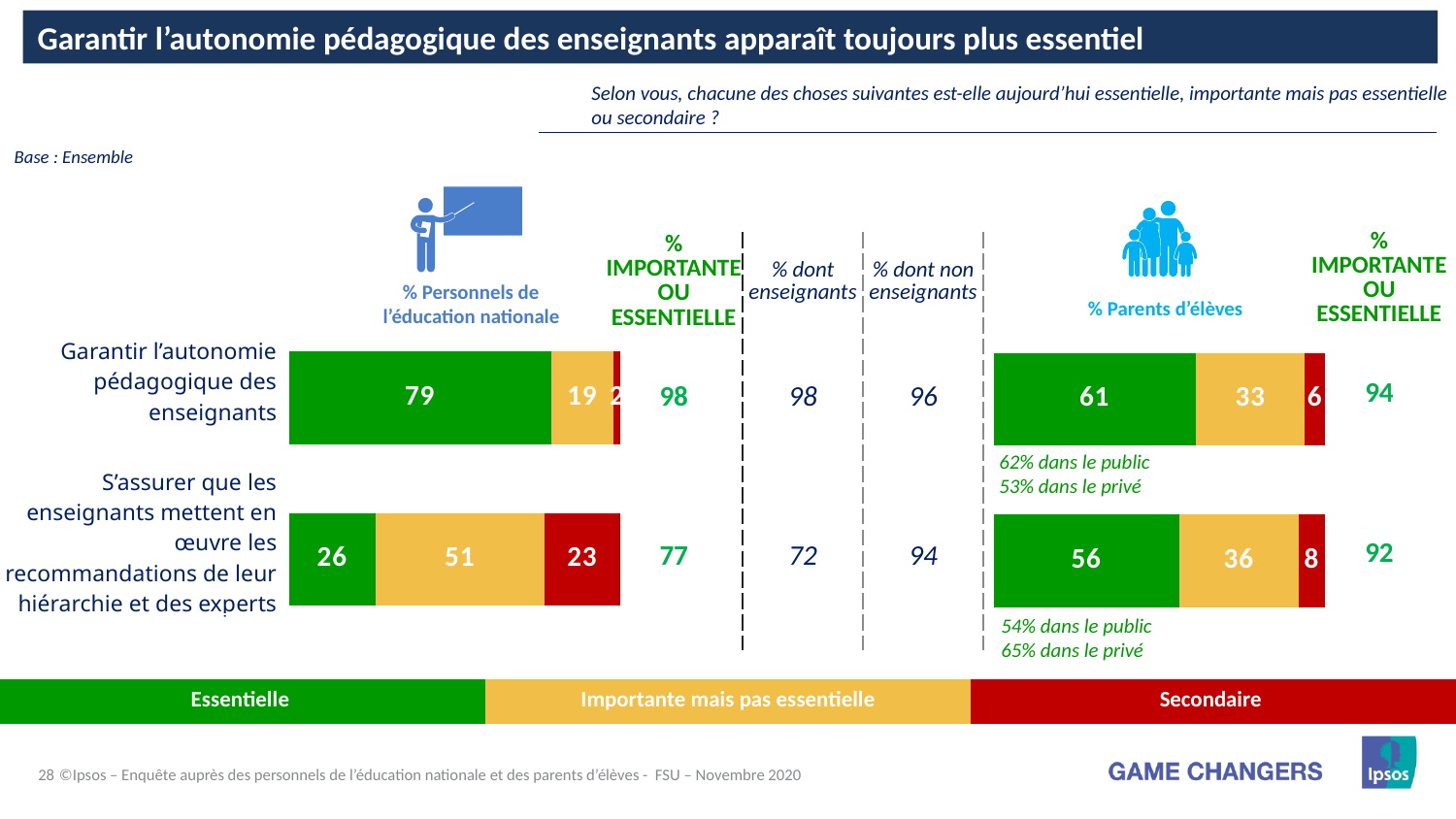
Is the Essentielle value for 'Garantir l'autonomie pédagogique des enseignants' larger in the '% Personnels de l'éducation nationale' chart or in the '% Parents d'élèves' chart? % Personnels de l'éducation nationale In the '% Personnels de l'éducation nationale' chart, what percentage rate 'Garantir l'autonomie pédagogique des enseignants' as Essentielle? 79 In the '% Parents d'élèves' chart, what is the 'Importante mais pas essentielle' value for 'Garantir l'autonomie pédagogique des enseignants'? 33 In the '% Personnels de l'éducation nationale' chart, which item has the higher Essentielle value? Garantir l'autonomie pédagogique des enseignants In the '% Parents d'élèves' chart, what is the difference between the Secondaire values of the two items? 2 In the '% Personnels de l'éducation nationale' chart, what is the 'Importante mais pas essentielle' value for 'S'assurer que les enseignants mettent en œuvre les recommandations de leur hiérarchie et des experts'? 51 In the '% Personnels de l'éducation nationale' chart, what is the difference between the Essentielle values of the two items? 53 How many series does the legend at the bottom of the slide list? 3 How many items (categories) are shown in the '% Personnels de l'éducation nationale' chart? 2 What kind of chart is used to show the '% Parents d'élèves' results? Stacked bar chart In the '% Parents d'élèves' chart, what percentage rate 'S'assurer que les enseignants mettent en œuvre les recommandations de leur hiérarchie et des experts' as Secondaire? 8 In the '% Parents d'élèves' chart, which item has the lower Essentielle value? S'assurer que les enseignants mettent en œuvre les recommandations de leur hiérarchie et des experts